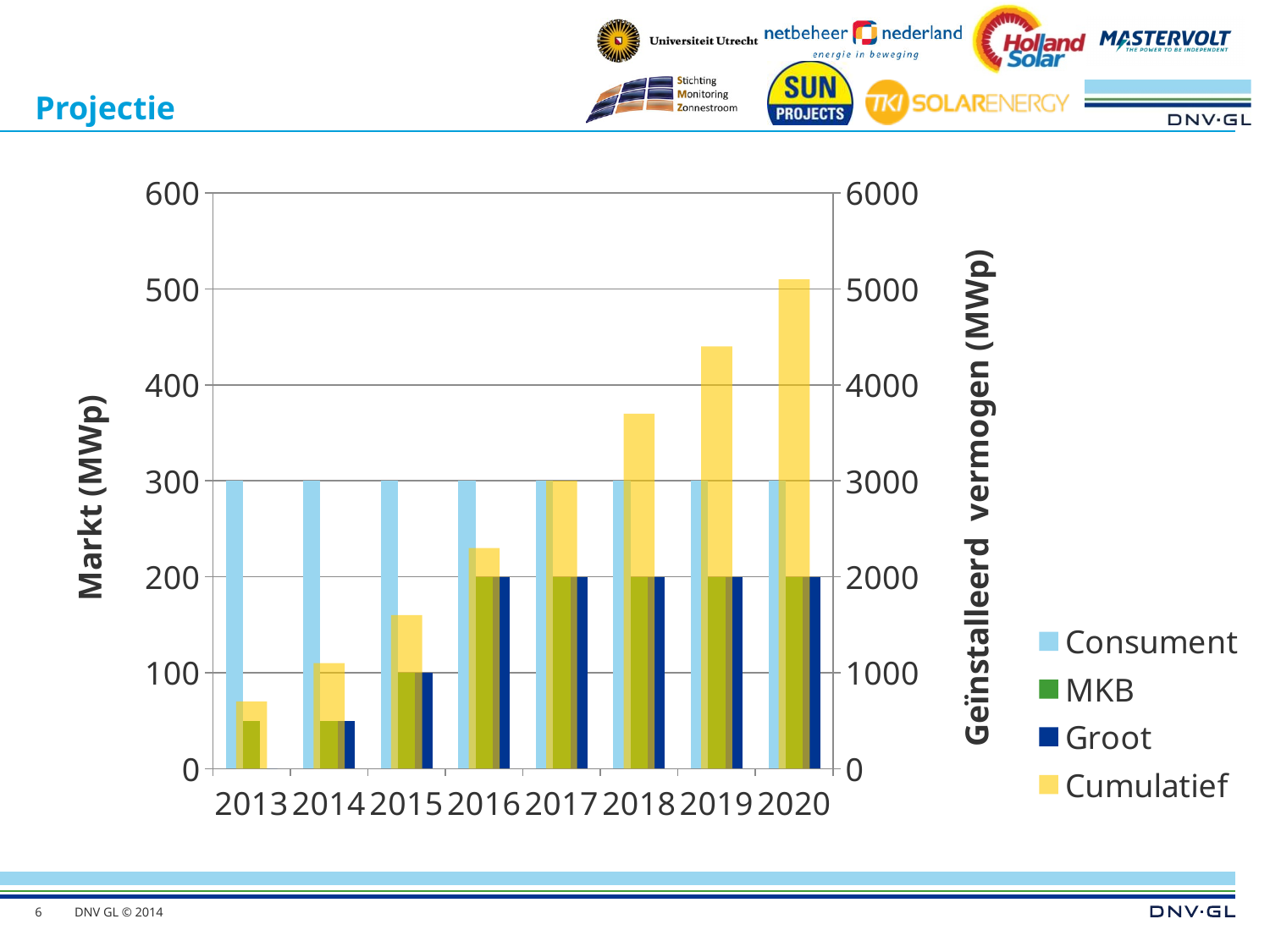
What is the title of the left vertical axis? Markt (MWp) Is the value for Cumulatief in 2013 greater or less than 1000? less Is the value for Cumulatief in 2020 greater or less than 4000? greater What kind of chart is shown on the slide? bar chart How many series does the legend list? 4 What is the value for Groot in 2015? 100 What is the value for MKB in 2016? 200 How many years are shown on the x axis? 8 Do the Cumulatief values rise or fall from 2013 to 2020? rise What is the value for Cumulatief in 2017 on the right axis? 3000 Which of Groot in 2014 or Groot in 2016 is larger? Groot in 2016 What is the value for Consument in 2013? 300